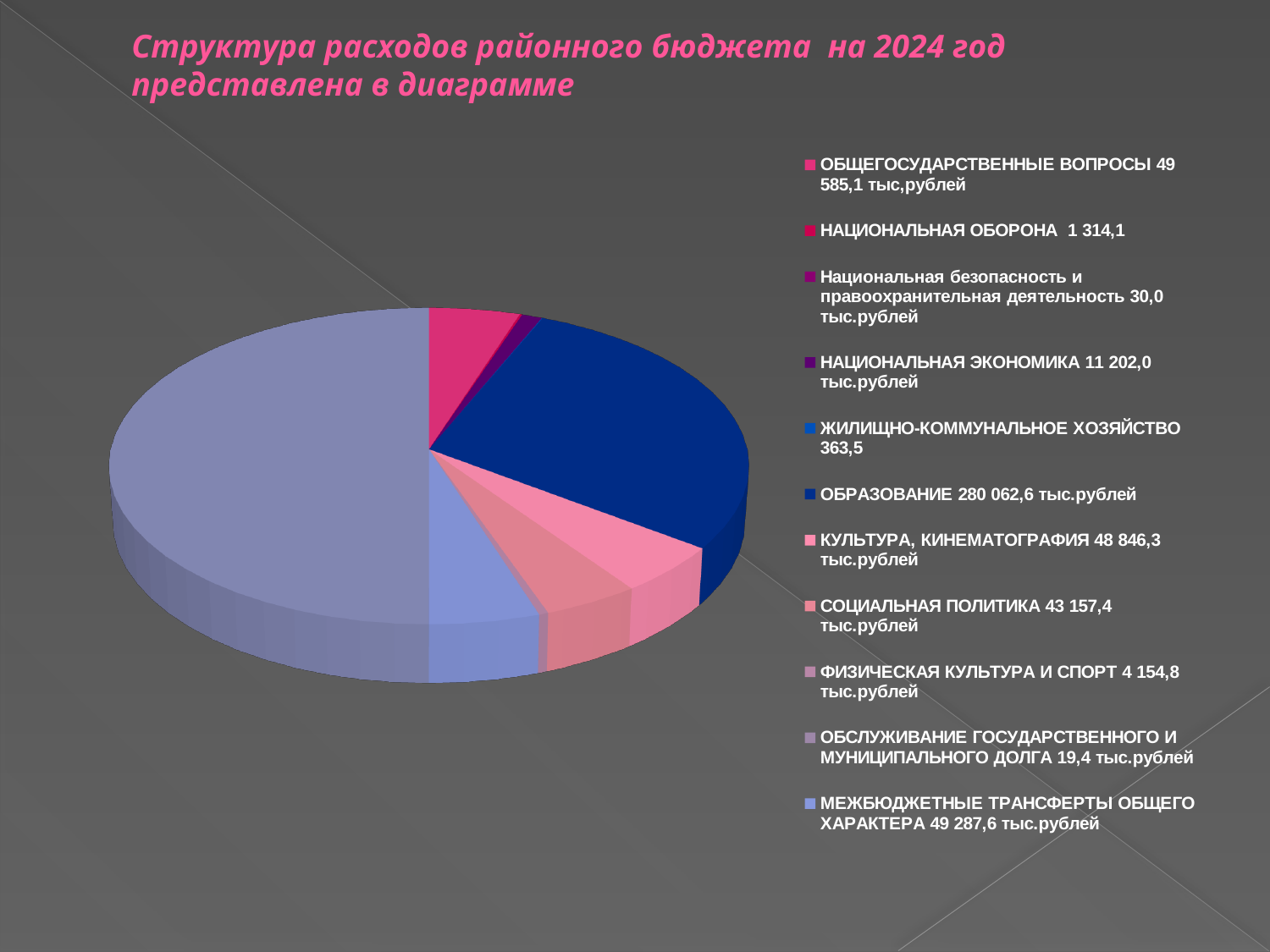
What value is given in the legend for ЖИЛИЩНО-КОММУНАЛЬНОЕ ХОЗЯЙСТВО? 363,5 What kind of chart is shown on the slide? Pie chart Which has the larger legend value: ОБЩЕГОСУДАРСТВЕННЫЕ ВОПРОСЫ or МЕЖБЮДЖЕТНЫЕ ТРАНСФЕРТЫ ОБЩЕГО ХАРАКТЕРА? ОБЩЕГОСУДАРСТВЕННЫЕ ВОПРОСЫ What value is given in the legend for НАЦИОНАЛЬНАЯ ЭКОНОМИКА? 11 202,0 тыс.рублей What value is given in the legend for ОБСЛУЖИВАНИЕ ГОСУДАРСТВЕННОГО И МУНИЦИПАЛЬНОГО ДОЛГА? 19,4 тыс.рублей According to the values printed in the legend, which category has the smallest amount? ОБСЛУЖИВАНИЕ ГОСУДАРСТВЕННОГО И МУНИЦИПАЛЬНОГО ДОЛГА What value is given in the legend for ОБРАЗОВАНИЕ? 280 062,6 тыс.рублей What value is given in the legend for СОЦИАЛЬНАЯ ПОЛИТИКА? 43 157,4 тыс.рублей By how much does the legend value for КУЛЬТУРА, КИНЕМАТОГРАФИЯ exceed that for СОЦИАЛЬНАЯ ПОЛИТИКА? 5 688,9 тыс.рублей How many categories does the legend of the pie chart list? 11 According to the values printed in the legend, which category has the largest amount? ОБРАЗОВАНИЕ What year does the slide title say the district budget expenditure structure is for? 2024